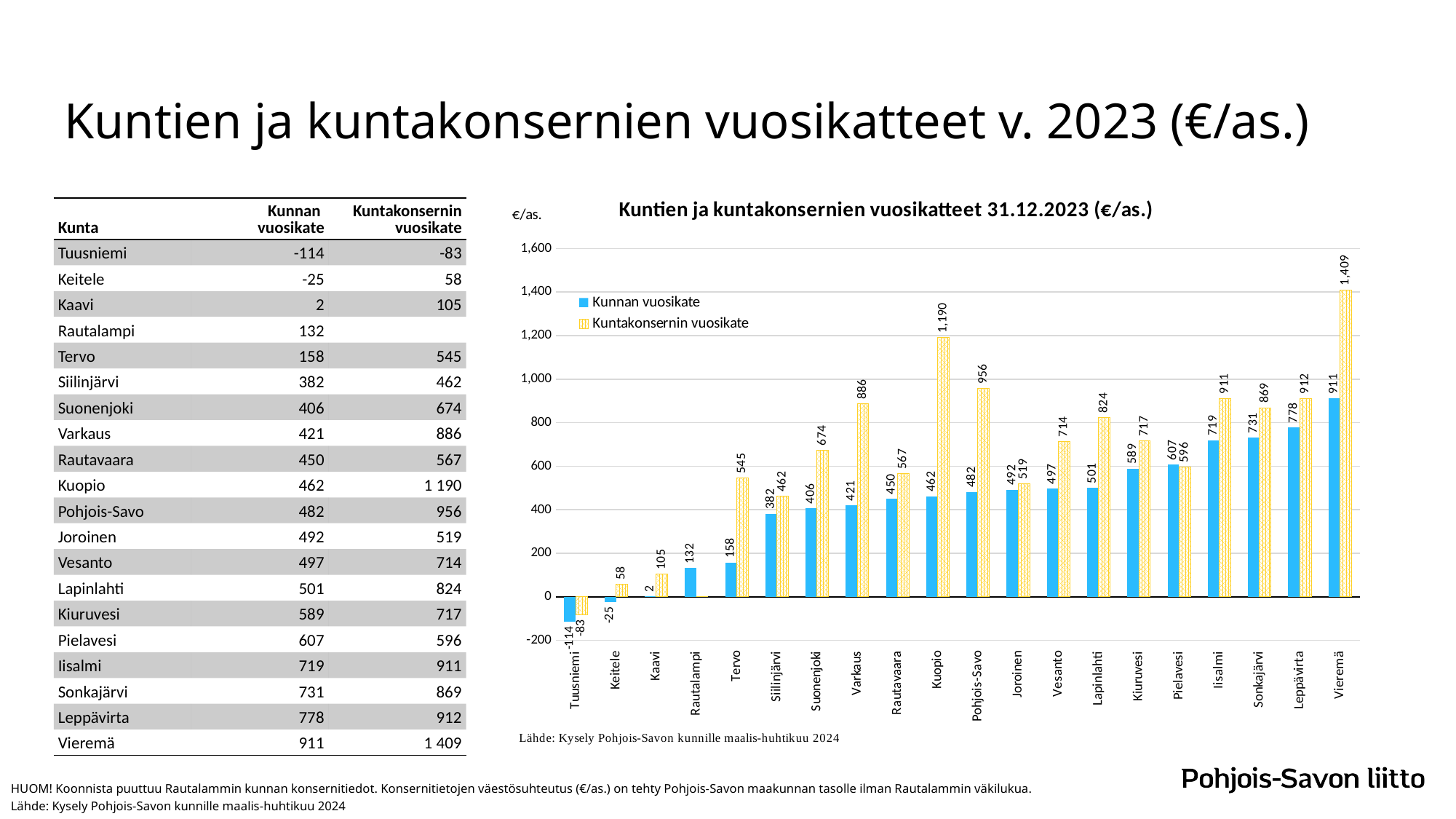
What is the title of the chart? Kuntien ja kuntakonsernien vuosikatteet 31.12.2023 (€/as.) For Pielavesi, which is larger: Kunnan vuosikate or Kuntakonsernin vuosikate? Kunnan vuosikate What is the Kunnan vuosikate value for Varkaus? 421 What is the Kuntakonsernin vuosikate value for Tervo? 545 Which municipality has the highest Kuntakonsernin vuosikate? Vieremä How many municipalities/categories are shown on the x axis of the chart? 20 How many series does the chart legend list? 2 What is the difference between the Kuntakonsernin vuosikate and the Kunnan vuosikate for Vieremä? 498 What is the Kuntakonsernin vuosikate value for Kuopio? 1,190 What kind of chart is shown on the slide? Bar chart Which municipality has the lowest Kunnan vuosikate? Tuusniemi Do the Kunnan vuosikate values rise or fall from left to right along the x axis? Rise